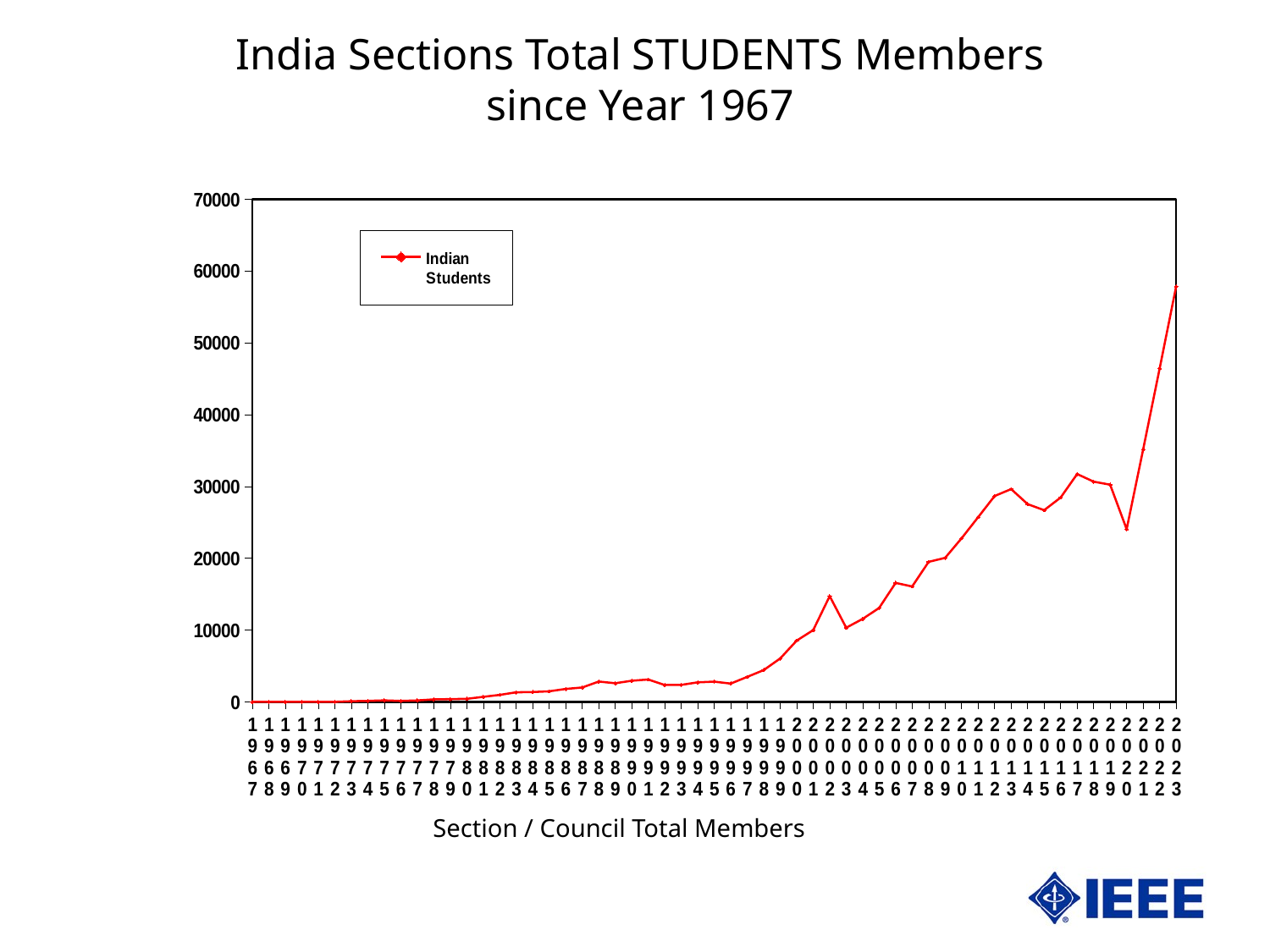
How many years (data points) are plotted along the x axis? 57 Overall, do the values rise or fall from 1967 to 2023? rise How many series does the legend list? 1 Is the value for 2022 greater or less than 40000? greater Is the value for 2023 greater or less than 50000? greater Which year has the larger value, 2019 or 2020? 2019 What is the title of the chart? India Sections Total STUDENTS Members since Year 1967 Is the value for 2020 greater or less than 30000? less Which year has the highest number of Indian Students? 2023 What is the name of the series shown in the legend? Indian Students What kind of chart is shown on the slide? line chart